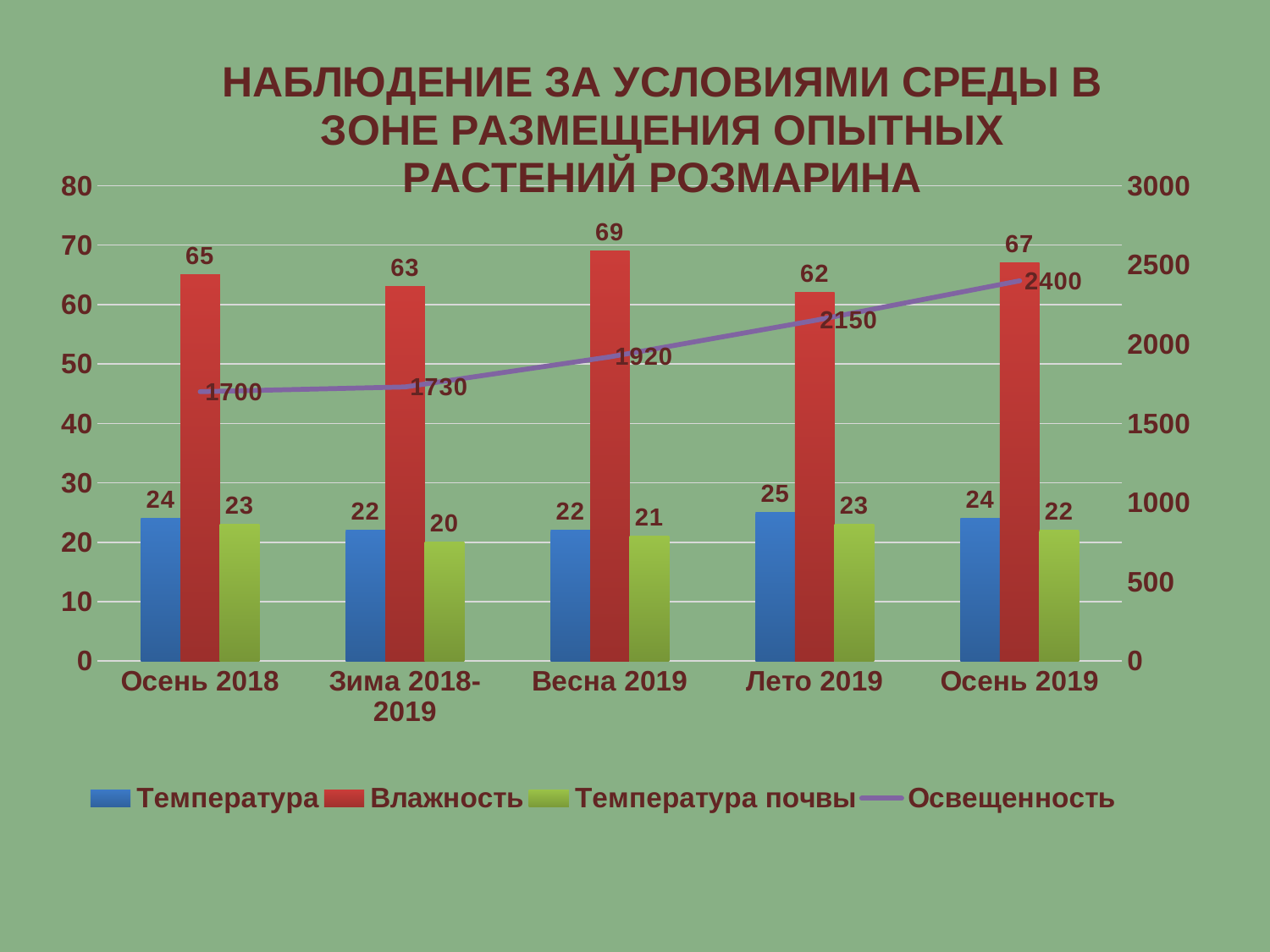
Which is larger, the Температура value for Лето 2019 or for Зима 2018-2019? Лето 2019 What is the Освещенность value for Лето 2019? 2150 Which category has the highest Влажность value? Весна 2019 What is the Влажность value for Весна 2019? 69 How many categories are shown on the x axis? 5 What is the difference between the Влажность values for Весна 2019 and Лето 2019? 7 Does the Освещенность line rise or fall from Осень 2018 to Осень 2019? Rises What is the Температура почвы value for Зима 2018-2019? 20 What kind of chart is this? Combined bar and line chart How many series does the legend list? 4 Which category has the lowest Освещенность value? Осень 2018 Which series is plotted as a line? Освещенность